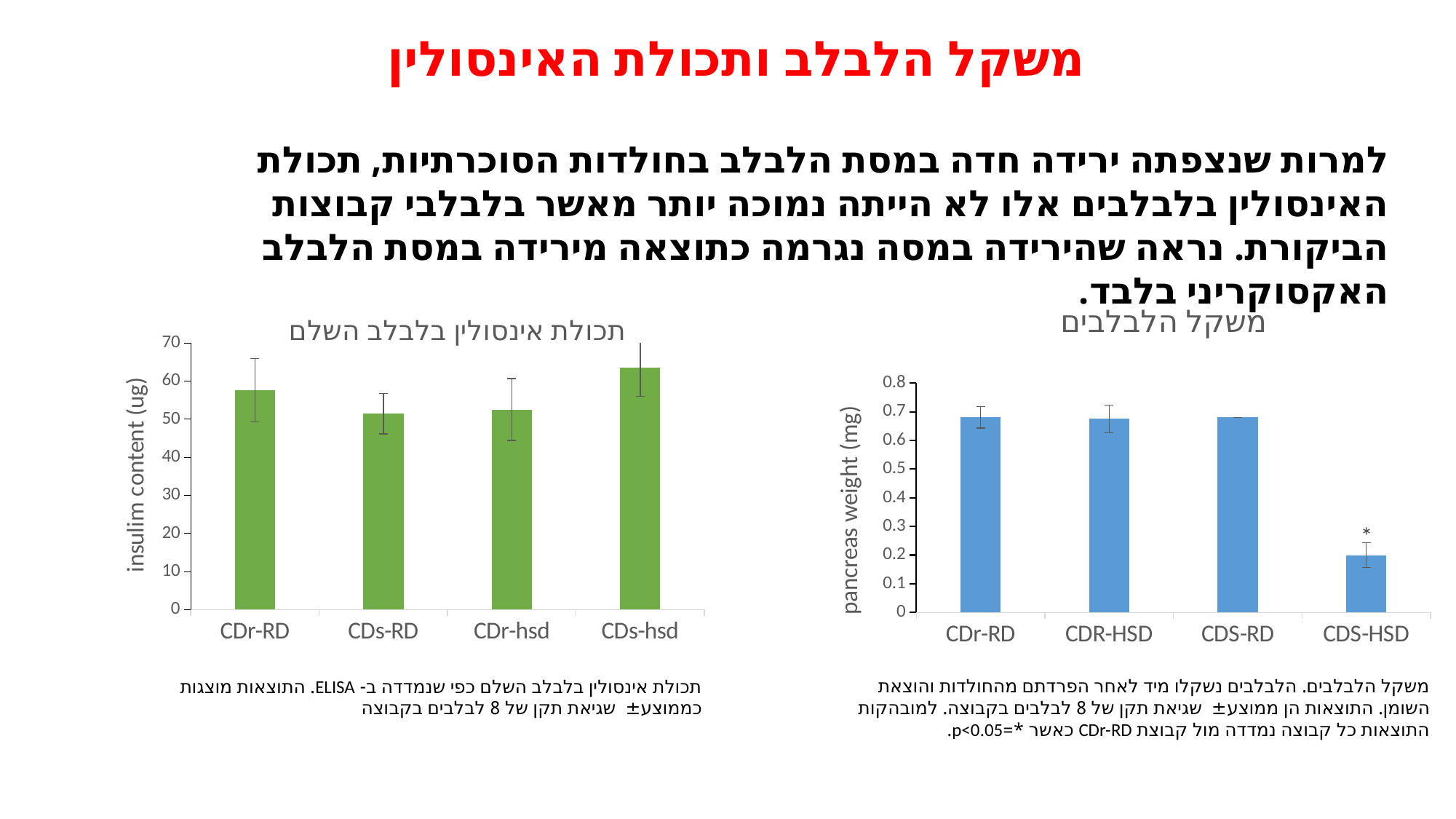
What colour are the bars in the left chart titled "תכולת אינסולין בלבלב השלם"? green In the left chart (insulin content), is the value for CDs-hsd greater or less than 60? greater In the left chart (insulin content), which category has the highest bar? CDs-hsd In the left chart (insulin content), which is larger, the value for CDs-hsd or the value for CDr-RD? CDs-hsd In the right chart (pancreas weight), is the value for CDS-HSD greater or less than 0.3? less In the right chart (pancreas weight), which is larger, the value for CDS-RD or the value for CDS-HSD? CDS-RD How many categories are shown on the x axis of the right chart titled "משקל הלבלבים"? 4 In the right chart (pancreas weight), which category has the lowest bar? CDS-HSD What kind of chart is the left chart titled "תכולת אינסולין בלבלב השלם"? bar chart In the left chart (insulin content), is the value for CDr-RD greater or less than 50? greater What is the y-axis label of the right chart titled "משקל הלבלבים"? pancreas weight (mg)